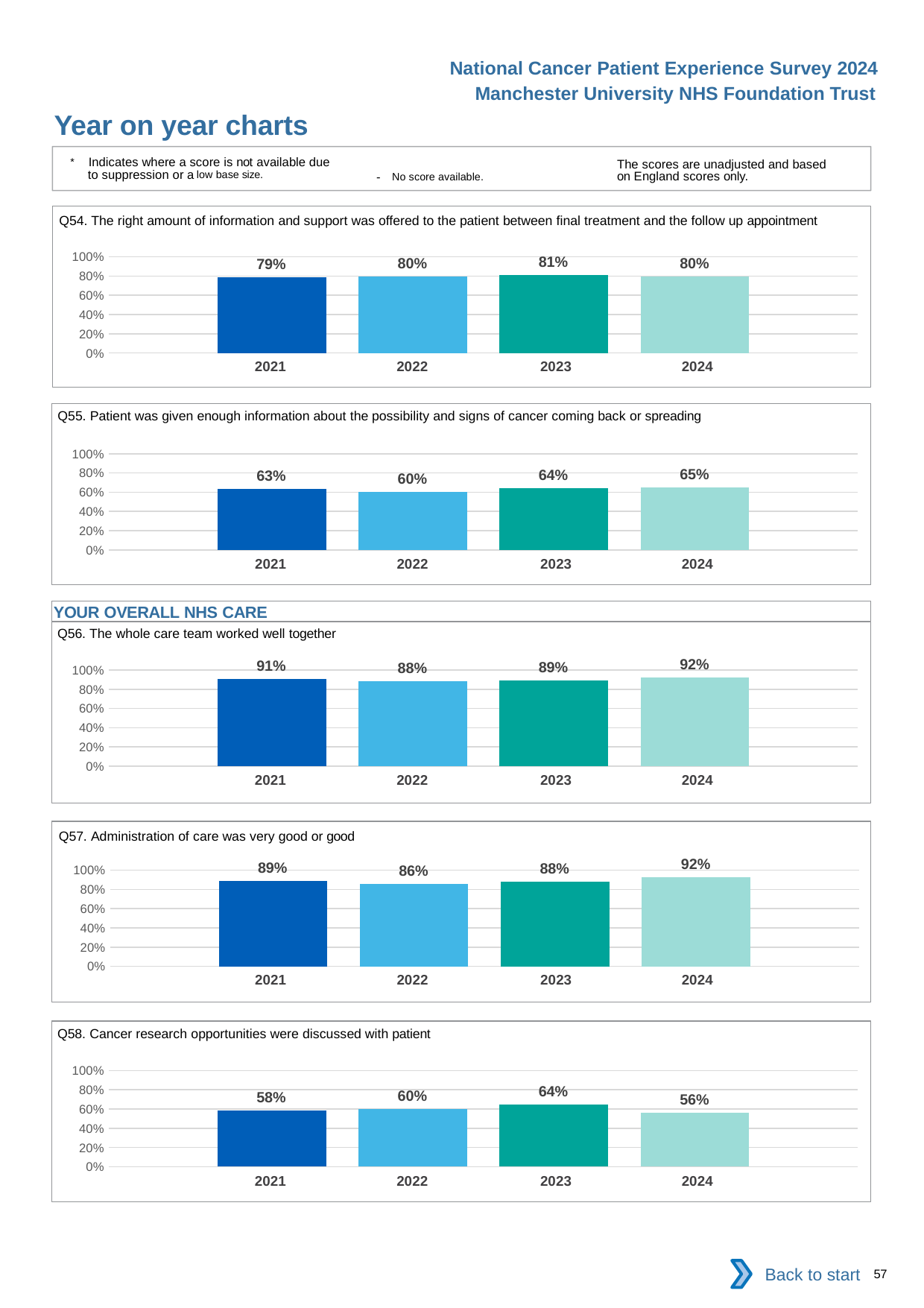
In the Q54 chart, what is the value for 2023? 81% In the Q57 chart, what is the difference between the 2024 and 2021 values? 3 percentage points What type of chart is used for Q58? bar chart In the Q57 chart, is the value for 2022 larger or smaller than the value for 2024? smaller In the Q55 chart, which year has the lowest value? 2022 In the Q55 chart, what is the difference between the 2024 and 2022 values? 5 percentage points In the Q58 chart, which year has the highest value? 2023 In the Q58 chart, what is the value for 2024? 56% In the Q56 chart, what is the value for 2021? 91% How many years are shown in the Q54 chart? 4 In the Q56 chart, which year has the highest value? 2024 In the Q58 chart, is the value for 2024 greater or less than 60%? less